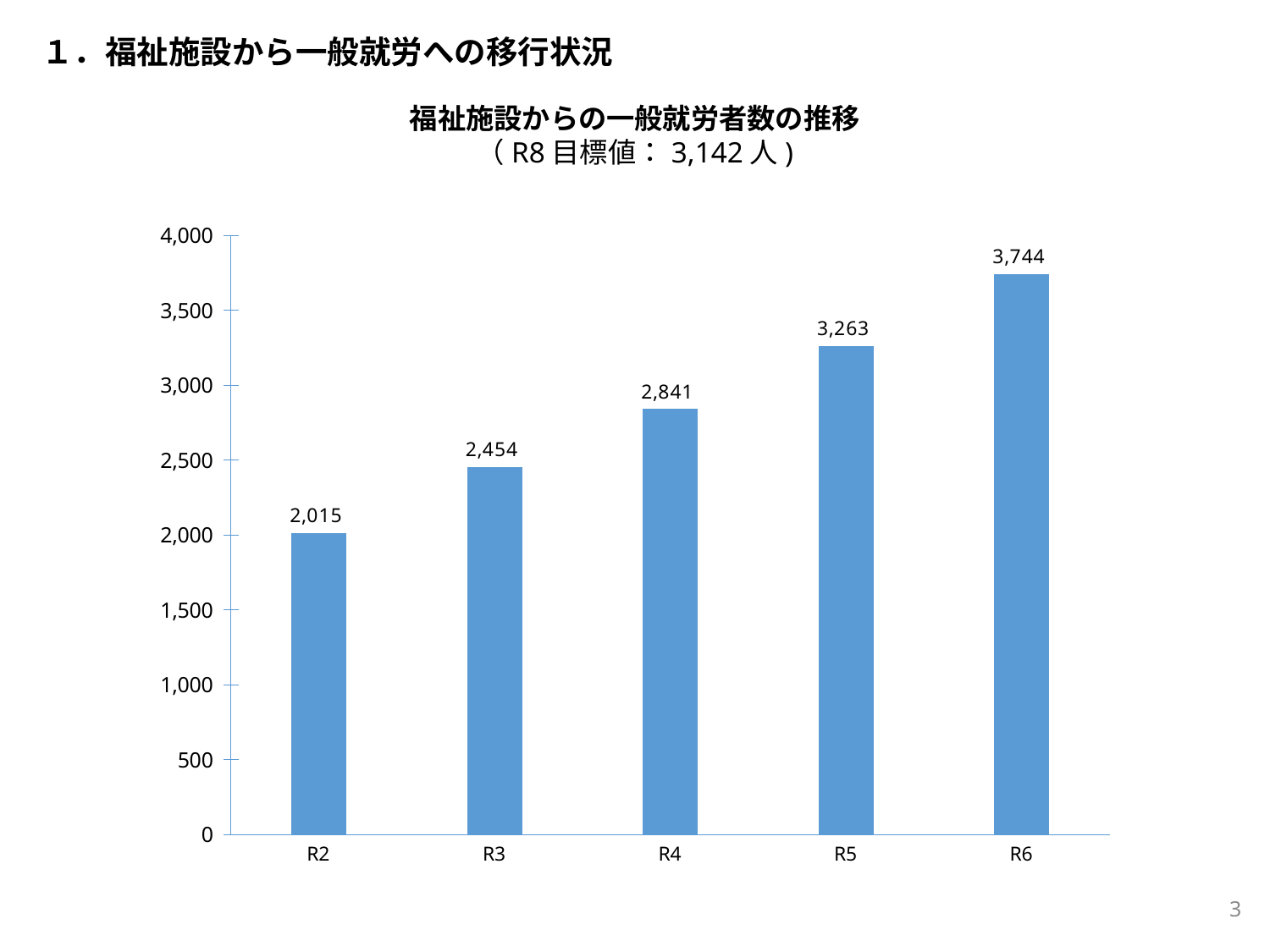
What kind of chart is this? bar chart What is the value for R2? 2,015 Is the value for R5 greater or less than 3,000? greater Do the values rise or fall from R2 to R6? rise How many years are shown on the x axis? 5 What is the value for R6? 3,744 Which year has the highest value? R6 What is the difference between the values for R3 and R2? 439 What is the value for R4? 2,841 Which is larger, the value for R4 or the value for R3? R4 What is the difference between the values for R6 and R5? 481 Which year has the lowest value? R2